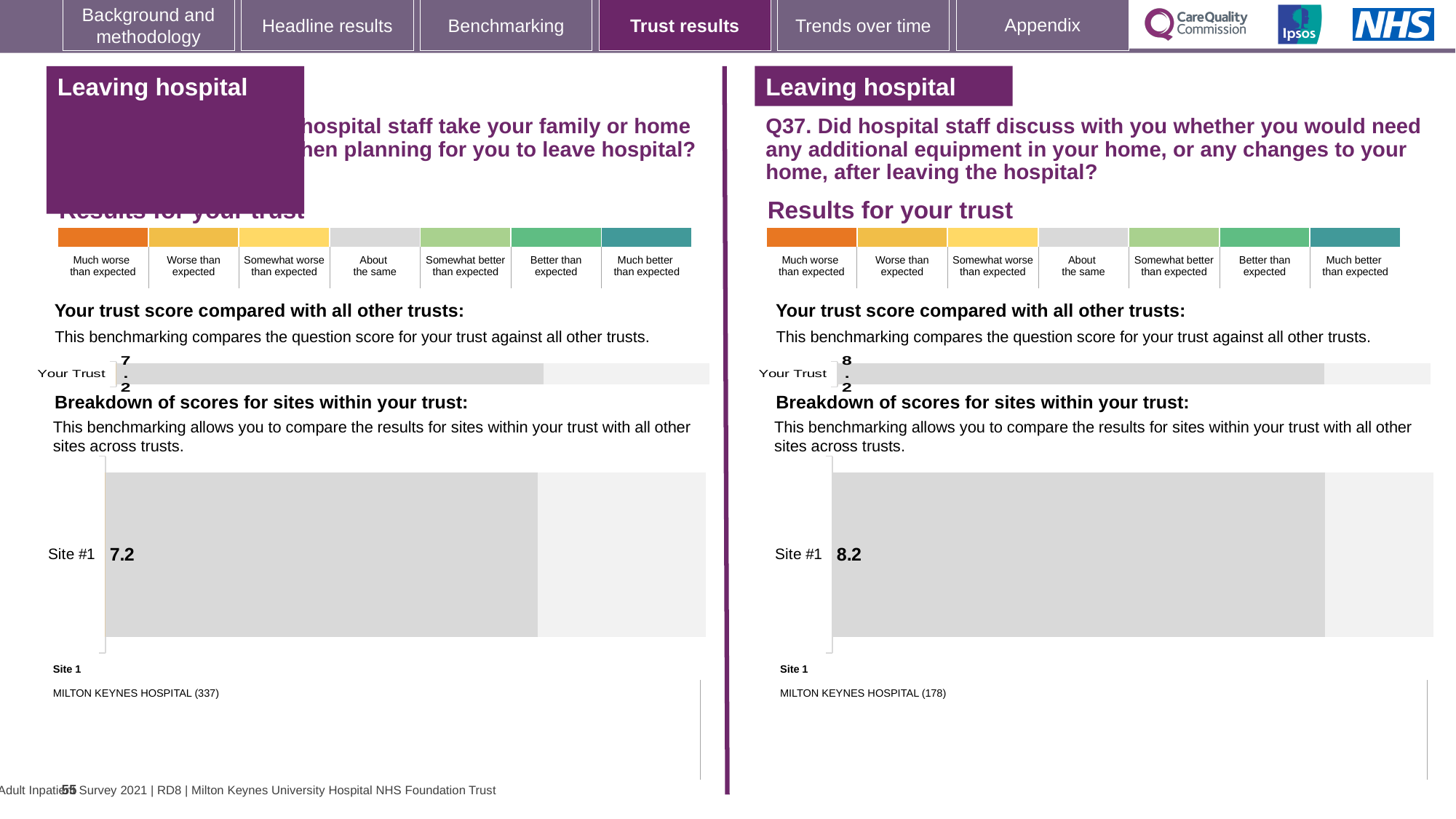
How many sites are shown in the right-hand 'Breakdown of scores for sites within your trust' chart? 1 What is the difference between the Your Trust score on the right-hand chart (8.2) and the Your Trust score on the left-hand chart (7.2)? 1.0 Comparing Site #1 on the left-hand breakdown chart with Site #1 on the right-hand breakdown chart, which has the larger value? The right-hand chart (Q37), 8.2 How many sites are shown in the left-hand 'Breakdown of scores for sites within your trust' chart? 1 Comparing the Your Trust scores on the left-hand and right-hand charts, which is larger? The right-hand chart (Q37), 8.2 On the right-hand half of the slide, which hospital is listed as Site 1? MILTON KEYNES HOSPITAL (178) On the right-hand 'Breakdown of scores for sites within your trust' chart (Q37), what is the value for Site #1? 8.2 What kind of chart is used to show the Your Trust score on each half of the slide? Bar chart On the right-hand chart 'Your trust score compared with all other trusts' (Q37), what is the value shown for Your Trust? 8.2 On the left-hand chart 'Your trust score compared with all other trusts', what is the value shown for Your Trust? 7.2 On the left-hand 'Breakdown of scores for sites within your trust' chart, what is the value for Site #1? 7.2 How many categories are shown in the colour scale above 'Your trust score compared with all other trusts' on the left-hand chart? 7